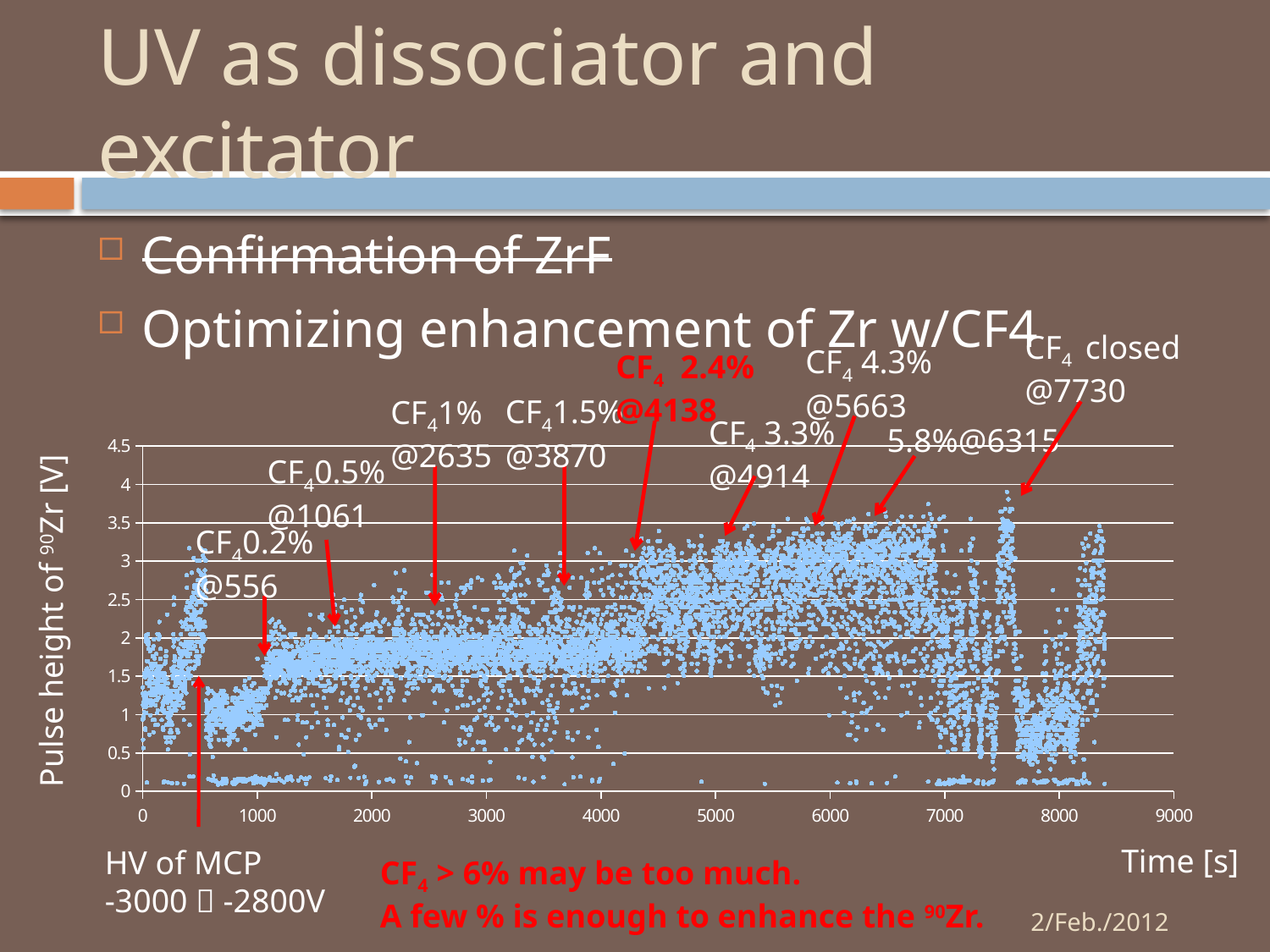
What is the highest tick value shown on the y axis? 4.5 What is the label of the y axis of the chart? Pulse height of 90Zr [V] What is the label of the x axis of the chart? Time [s] What kind of chart is shown on the slide? scatter plot At what time was CF4 closed, according to the annotation? @7730 At what time was CF4 4.3% introduced, according to the annotation? @5663 At what time (in seconds) was CF4 0.2% introduced, according to the annotation? @556 At what time was CF4 2.4% introduced, according to the annotation? @4138 At what time was CF4 1% introduced, according to the annotation? @2635 At what time was CF4 0.5% introduced, according to the annotation? @1061 Between about 1000 s and 7000 s, does the pulse height of the main band of points generally rise or fall as time increases? rise What is the highest tick value shown on the x axis? 9000